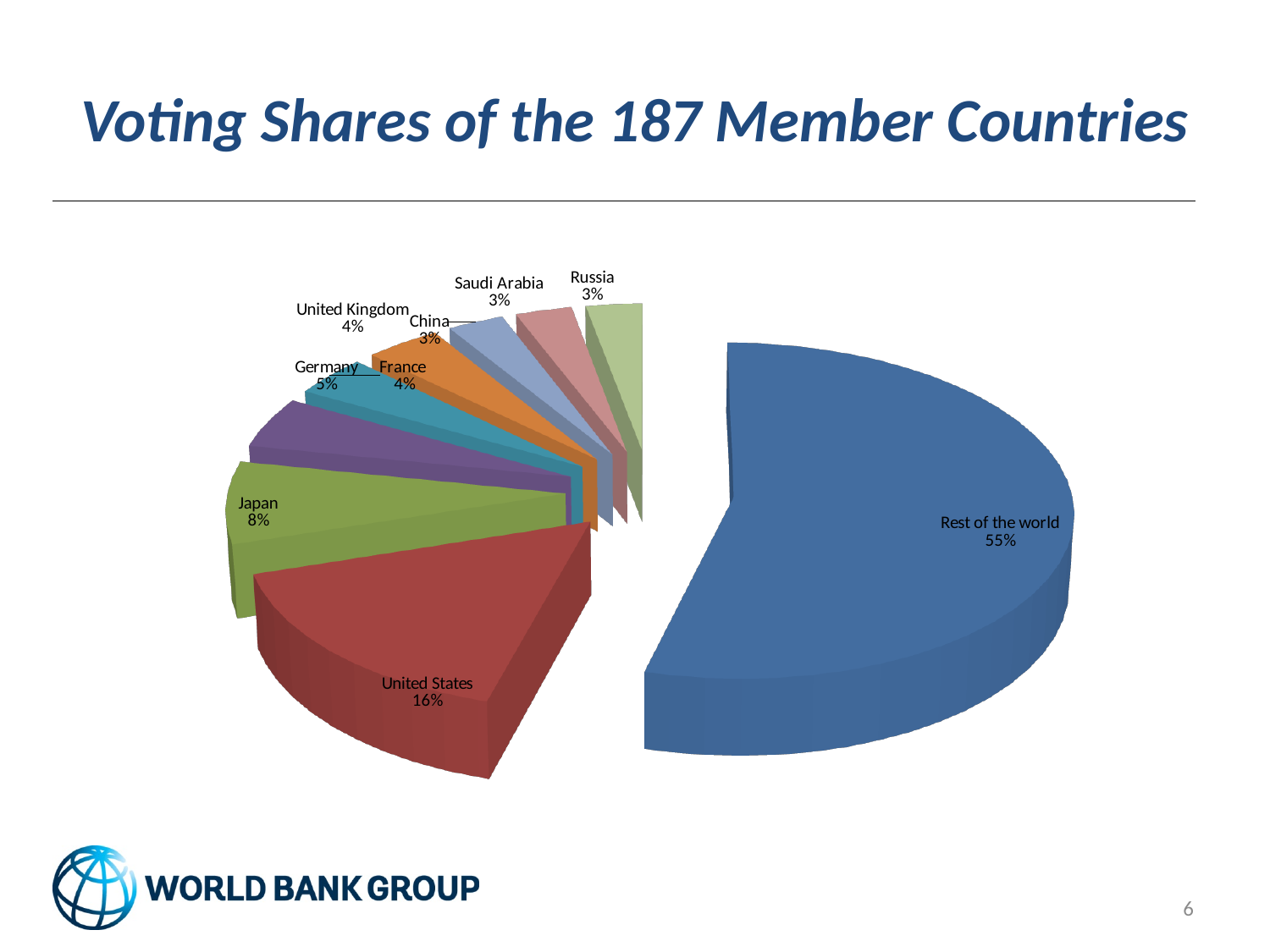
How many slices does the pie chart have? 9 What is the voting share of the United States? 16% Which slice has the largest share of the pie? Rest of the world What is the difference between the voting shares of the United Kingdom and China? 1% What is the difference between the voting shares of the United States and Japan? 8% What is the voting share of Germany? 5% What share of the pie does the Rest of the world slice represent? 55% What kind of chart is shown on the slide? Pie chart What is the voting share of Japan? 8% What is the title of the chart on the slide? Voting Shares of the 187 Member Countries What is the voting share of Saudi Arabia? 3% Which has a larger voting share, Germany or France? Germany